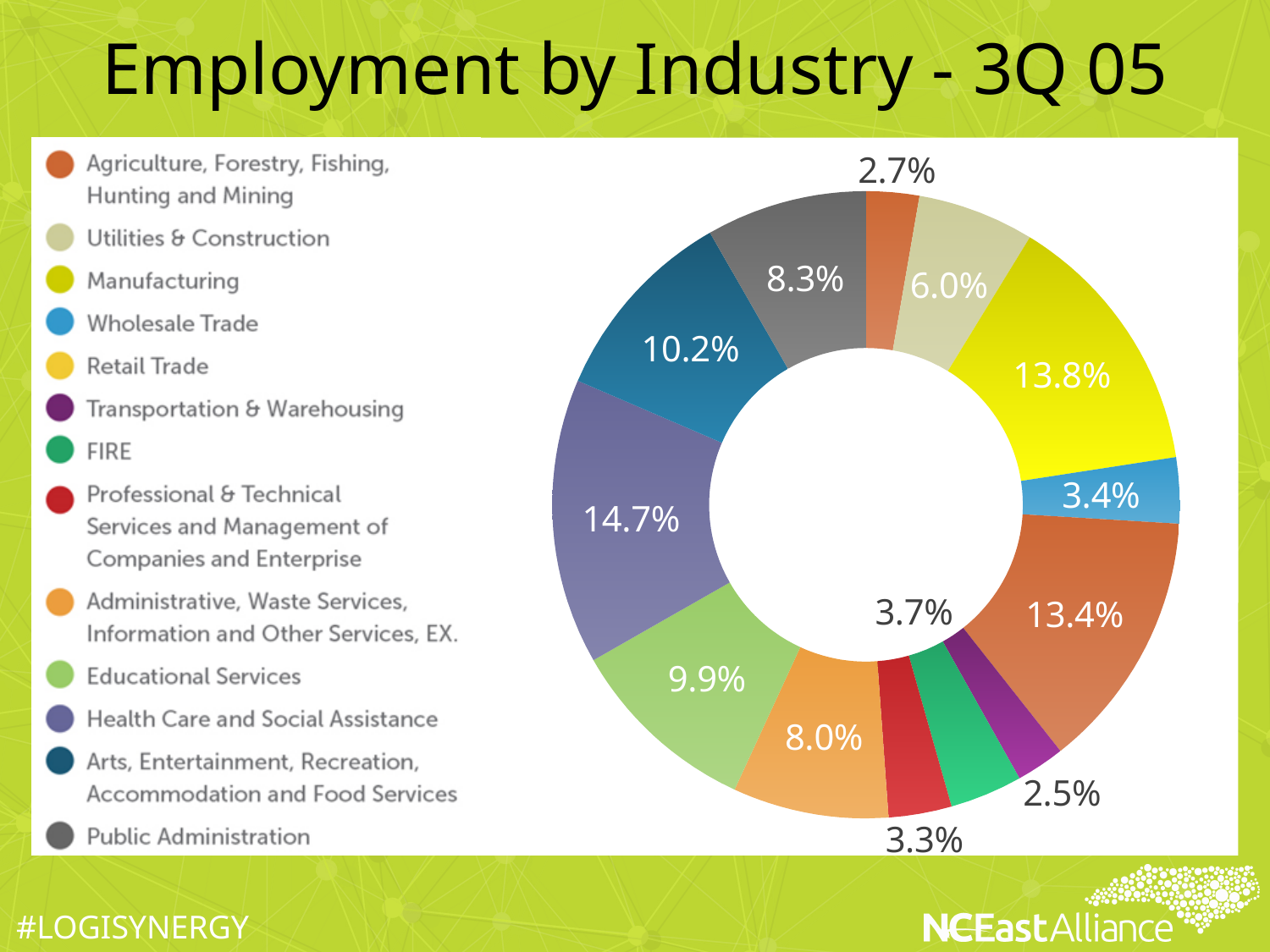
Which has a larger share: Educational Services or Administrative, Waste Services, Information and Other Services, EX.? Educational Services Which industry has the smallest share of employment? Transportation & Warehousing What is the title of the chart on the slide? Employment by Industry - 3Q 05 How many percentage points larger is Manufacturing's share than Wholesale Trade's share? 10.4 percentage points What is the employment share for Manufacturing? 13.8% How many industry categories does the legend list? 13 What kind of chart is shown on the slide? doughnut chart What is the employment share for Public Administration? 8.3% What is the employment share for Educational Services? 9.9% What is the employment share for Arts, Entertainment, Recreation, Accommodation and Food Services? 10.2% Which industry has the largest share of employment? Health Care and Social Assistance What is the employment share for Utilities & Construction? 6.0%